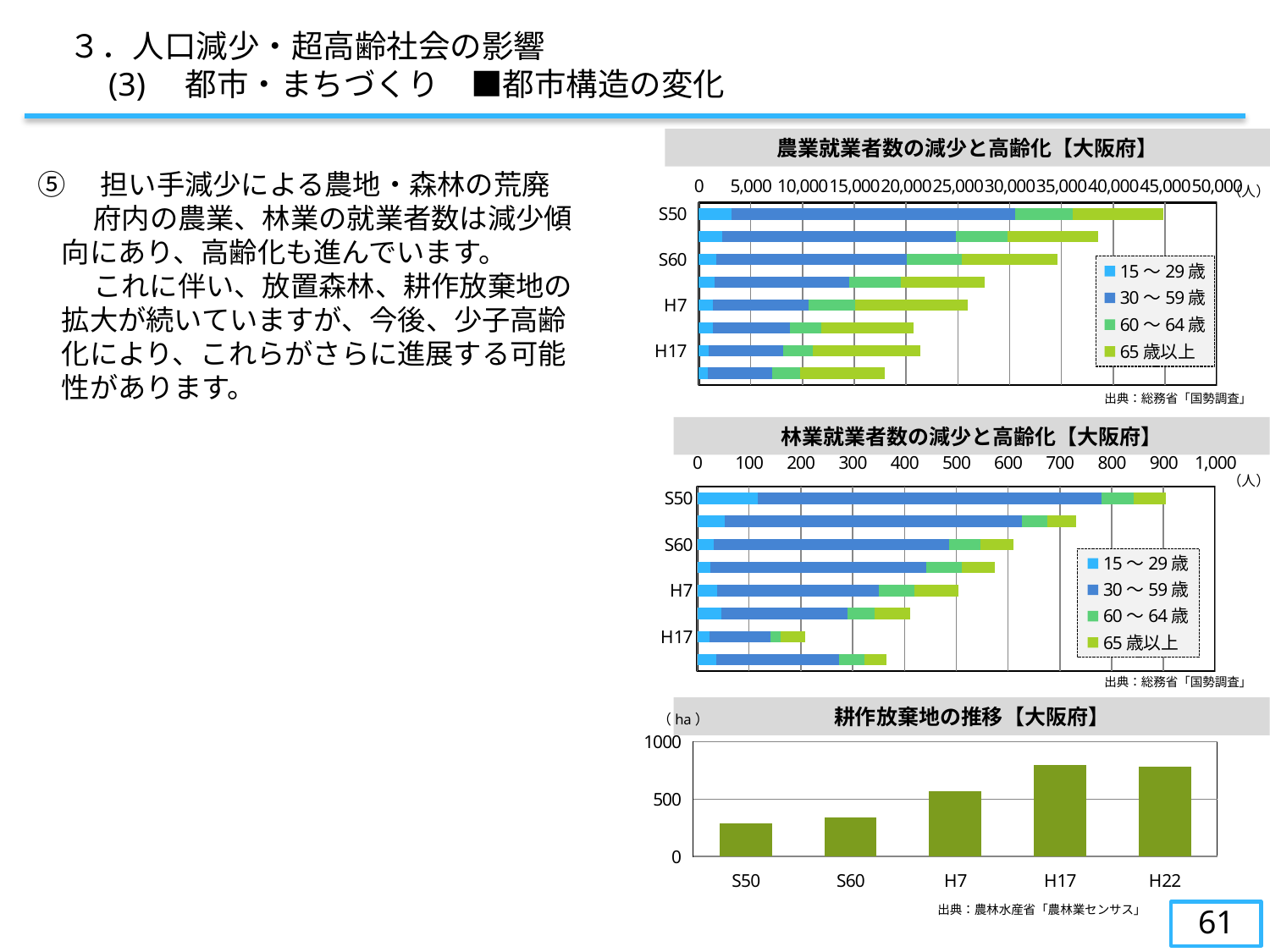
In the chart titled 耕作放棄地の推移【大阪府】, what unit is shown on the vertical axis? ha In the chart titled 林業就業者数の減少と高齢化【大阪府】, which legend entry is shown in light green? 65歳以上 In the chart titled 農業就業者数の減少と高齢化【大阪府】, how many series does the legend list? 4 In the chart titled 耕作放棄地の推移【大阪府】, how many categories are shown on the x axis? 5 In the chart titled 耕作放棄地の推移【大阪府】, is the value for S50 greater or less than 500? less In the chart titled 農業就業者数の減少と高齢化【大阪府】, do the total bar lengths rise or fall from S50 to the most recent bar? fall In the chart titled 耕作放棄地の推移【大阪府】, which is larger, the value for S60 or the value for H7? H7 In the chart titled 農業就業者数の減少と高齢化【大阪府】, is the total for the S50 bar greater or less than 40,000? greater In the chart titled 耕作放棄地の推移【大阪府】, is the value for H7 greater or less than 500? greater In the chart titled 林業就業者数の減少と高齢化【大阪府】, how many stacked bars are plotted? 8 In the chart titled 耕作放棄地の推移【大阪府】, what kind of chart is shown? bar chart